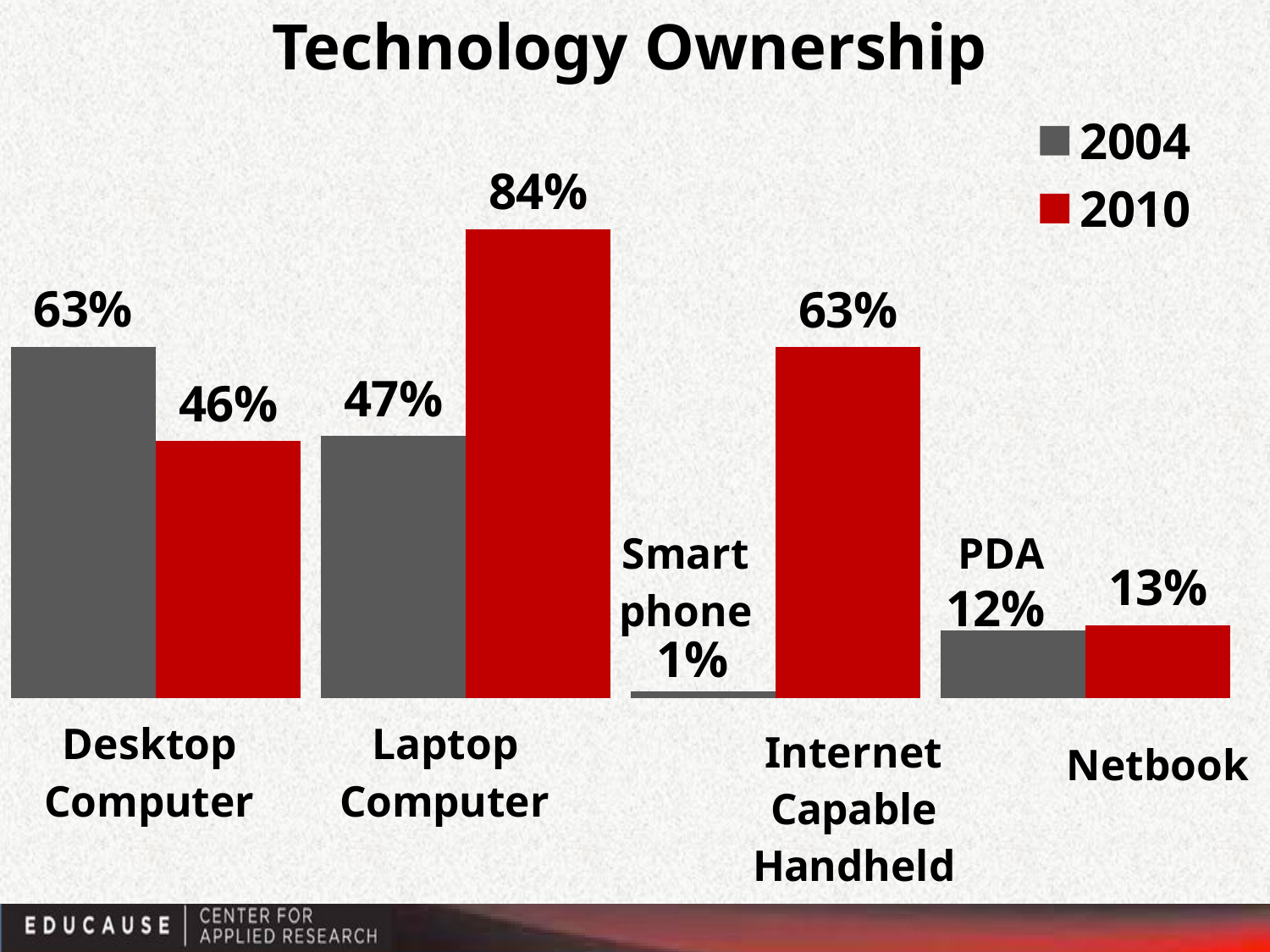
Which category has the lowest 2004 value? Internet Capable Handheld What is the difference between the 2010 and 2004 values for Laptop Computer? 37% What is the 2010 value for Internet Capable Handheld? 63% Which is larger for Desktop Computer, the 2004 value or the 2010 value? 2004 What is the 2010 value for Laptop Computer? 84% Which category has the highest 2010 value? Laptop Computer What is the 2010 value for Desktop Computer? 46% What is the title of the chart? Technology Ownership How many series does the legend list? 2 What is the 2004 value for Desktop Computer? 63% How many categories are shown on the x axis? 4 What kind of chart is shown on the slide? bar chart